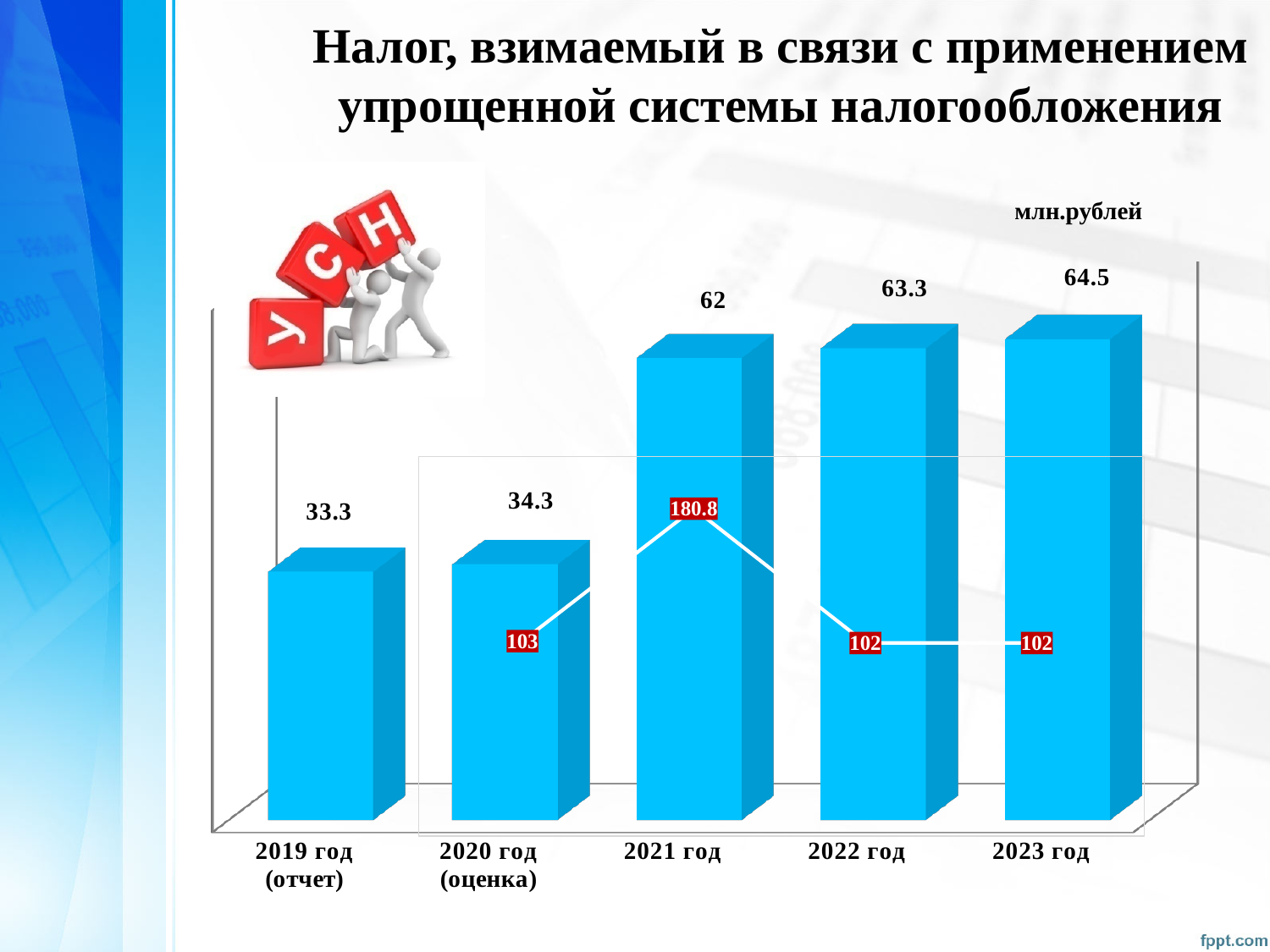
Which is larger, the bar value for 2022 год or for 2023 год? 2023 год What is the value for 2019 год (отчет)? 33.3 What is the difference between the bar values for 2021 год and 2020 год (оценка)? 27.7 How many years are shown on the x axis? 5 Which year has the highest bar value? 2023 год What is the value shown on the line for 2020 год (оценка)? 103 What kind of chart is this? bar chart What is the value shown on the line for 2021 год? 180.8 What is the value for 2021 год? 62 What is the value for 2023 год? 64.5 Do the bar values rise or fall from 2019 to 2023? rise Which year has the lowest bar value? 2019 год (отчет)